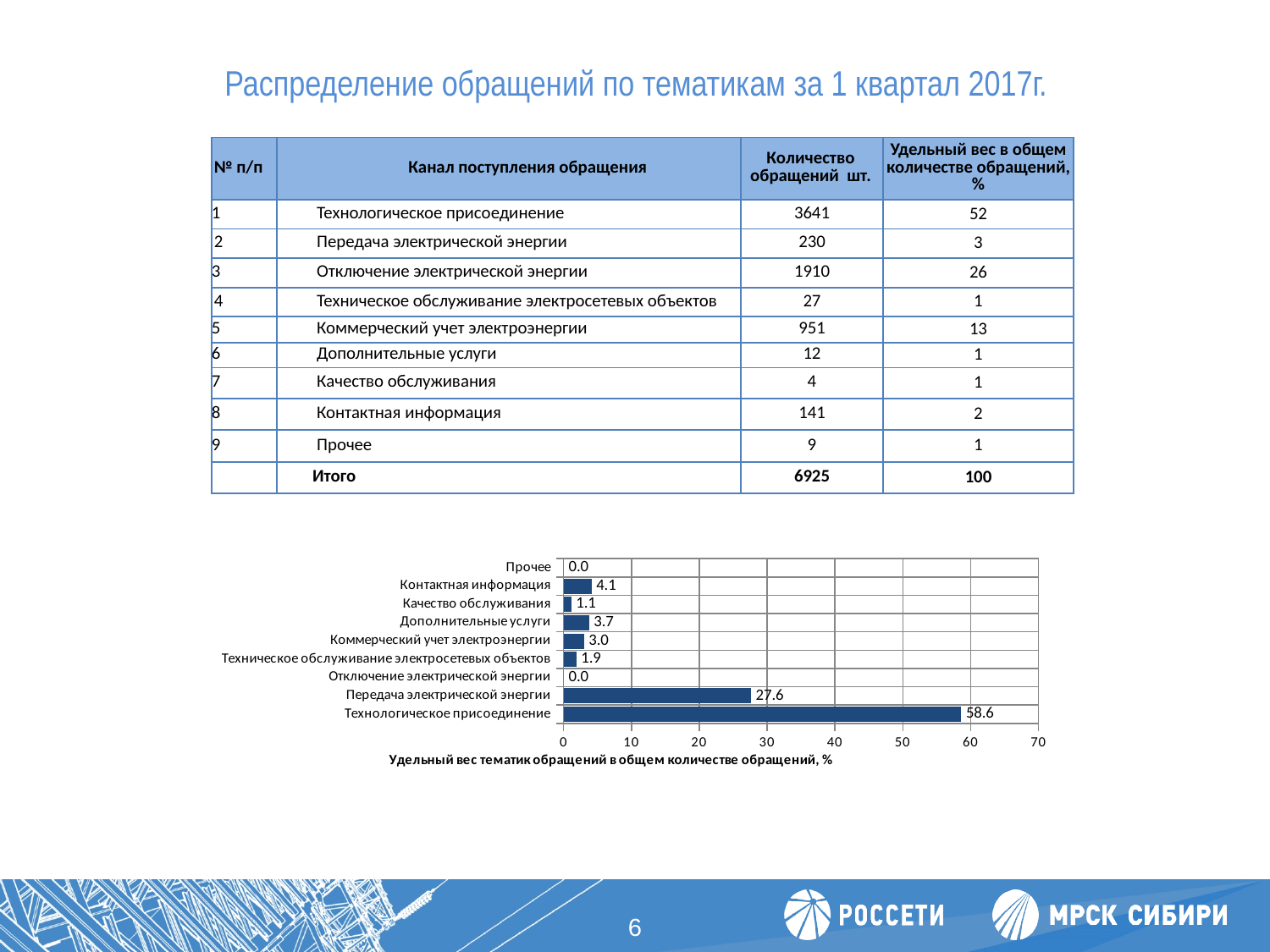
In the bar chart, which is larger: the value for Контактная информация or the value for Коммерческий учет электроэнергии? Контактная информация In the bar chart, what is the value for Техническое обслуживание электросетевых объектов? 1.9 In the bar chart, what is the value for Дополнительные услуги? 3.7 In the bar chart, is the value for Передача электрической энергии greater or less than 30? less In the bar chart, which category has the highest value? Технологическое присоединение What type of chart is shown on the slide? bar chart In the bar chart, what is the value for Передача электрической энергии? 27.6 In the bar chart, what is the value for Контактная информация? 4.1 In the bar chart, what is the difference between the values for Технологическое присоединение and Передача электрической энергии? 31.0 What is the axis title shown below the bar chart? Удельный вес тематик обращений в общем количестве обращений, % How many categories are shown in the bar chart? 9 In the bar chart, what is the value for Технологическое присоединение? 58.6